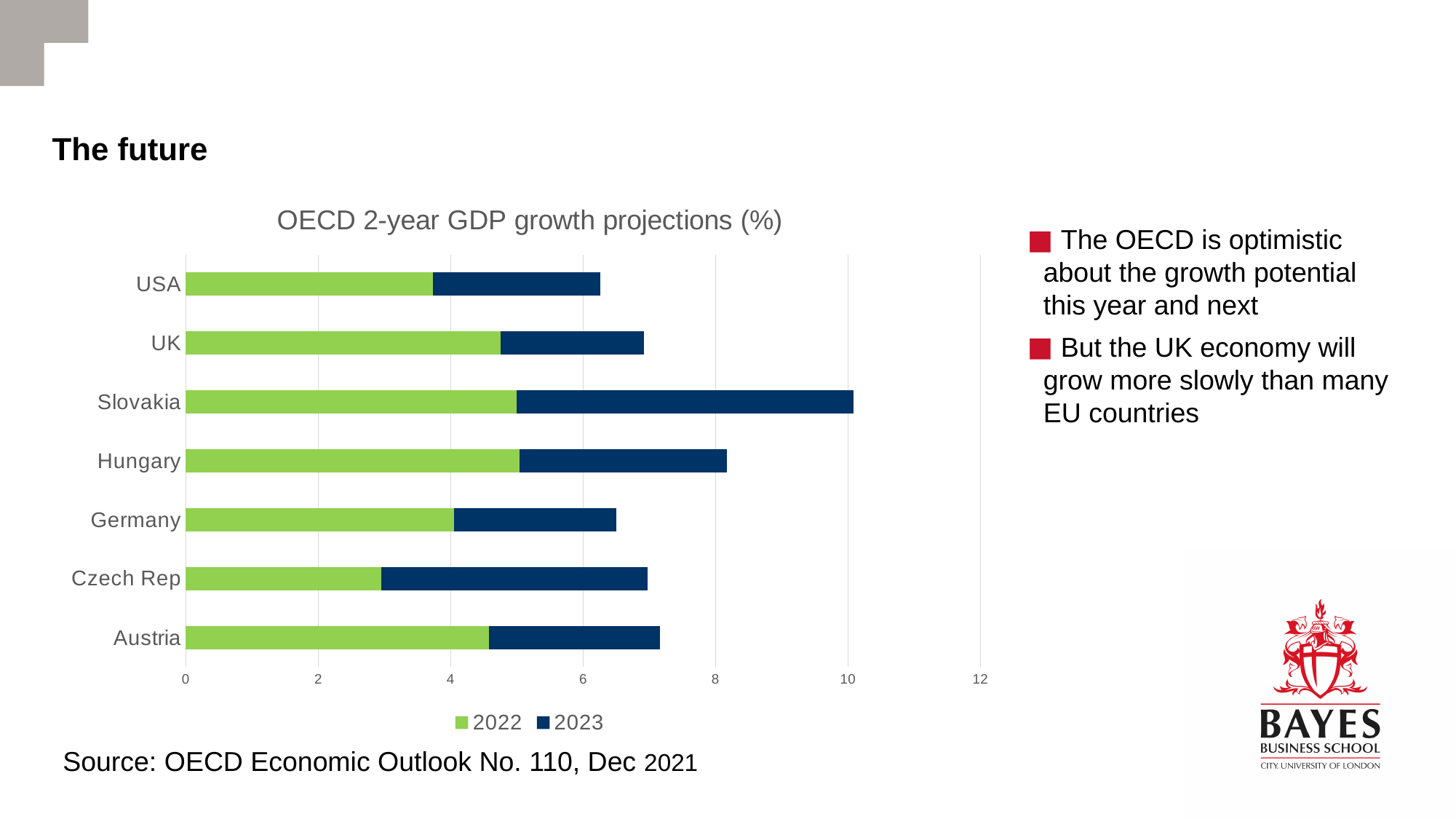
Which has the larger 2023 projection, Czech Rep or Austria? Czech Rep Is the combined 2-year projection for Slovakia greater or less than 8? greater What kind of chart is shown on the slide? Stacked bar chart Is the 2022 projection for the UK greater or less than 4? greater How many series does the legend list? 2 Which country has the lowest 2022 GDP growth projection? Czech Rep What is the title of the chart? OECD 2-year GDP growth projections (%) Which colour represents 2023 in the chart? Dark blue Which has the larger combined 2-year projection, Slovakia or Hungary? Slovakia Which country has the highest combined 2-year GDP growth projection? Slovakia How many countries are shown on the chart? 7 Is the 2022 projection for the USA greater or less than 4? less